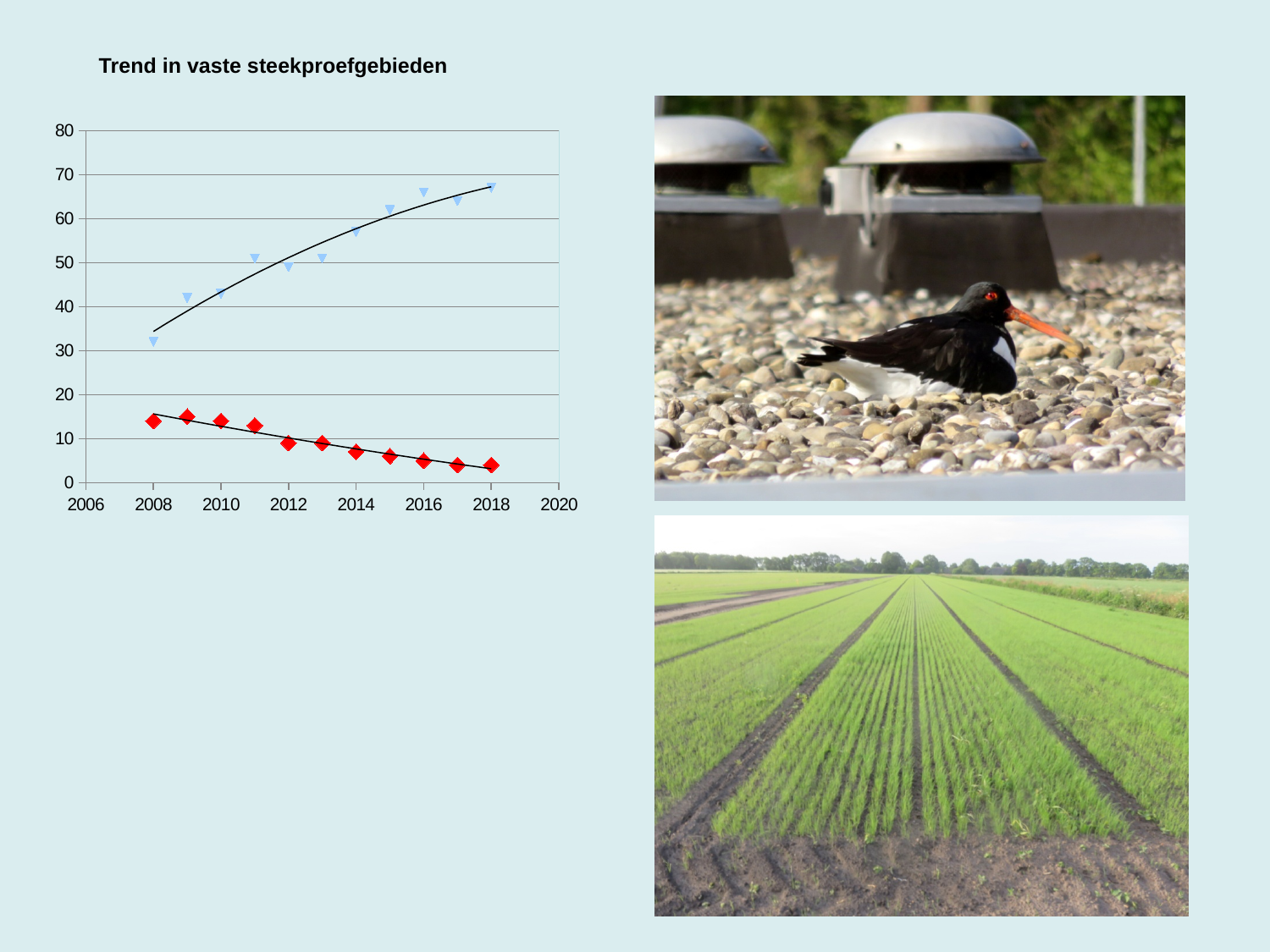
Is the value of the red diamond series in 2018 greater or less than 10? less What kind of chart is shown on the slide? scatter chart Is the value of the blue triangle series in 2018 greater or less than 60? greater How many data points does the blue triangle series have? 11 Is the value of the blue triangle series in 2014 greater or less than 50? greater In which year does the blue triangle series have its lowest value? 2008 Do the values of the blue triangle series rise or fall from 2008 to 2018? rise How many data series are plotted in the chart? 2 Do the values of the red diamond series rise or fall from 2008 to 2018? fall What is the title of the chart on the slide? Trend in vaste steekproefgebieden In 2018, which series has the larger value, the blue triangles or the red diamonds? blue triangles